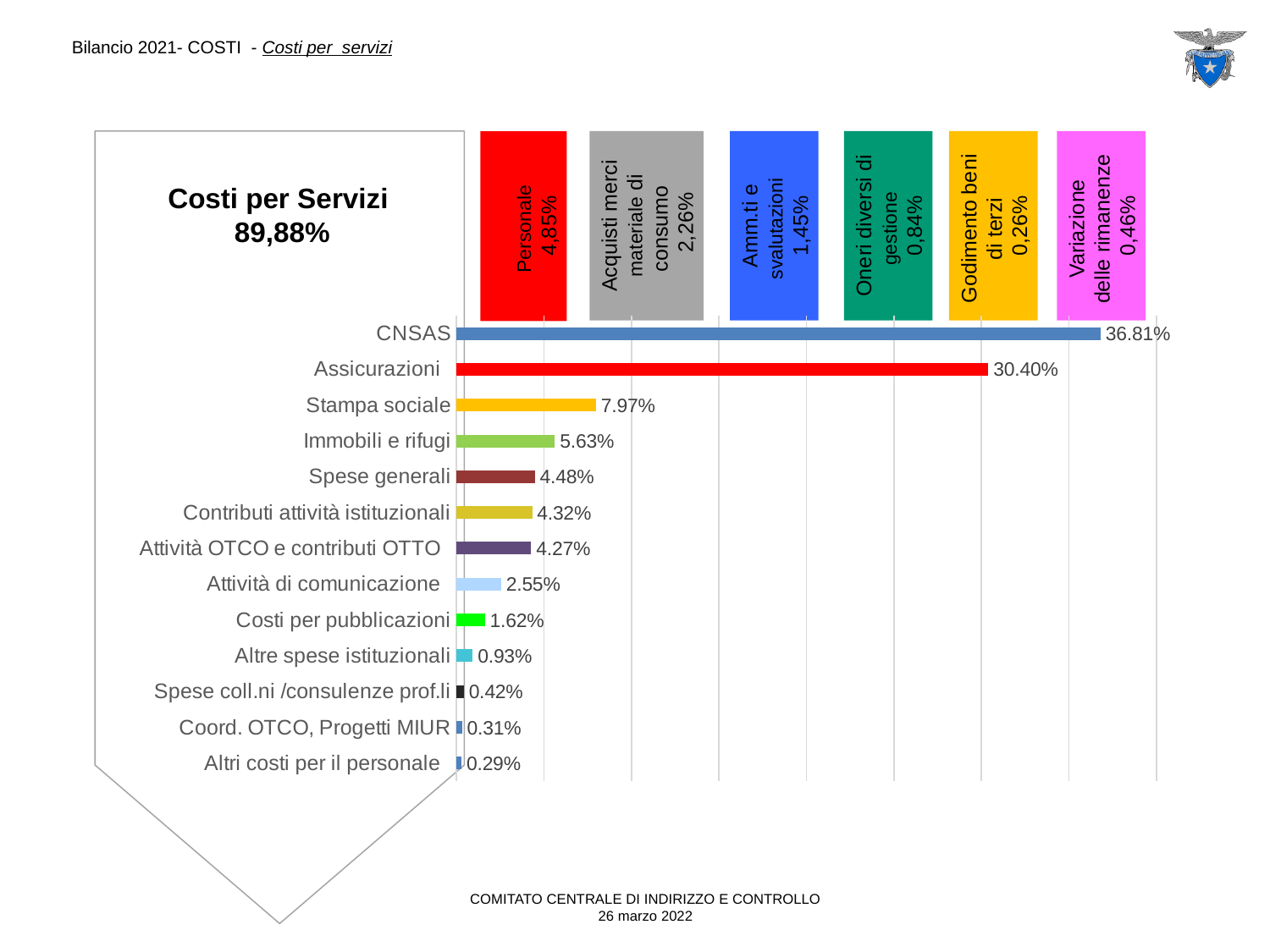
Which is larger, the value for Spese generali or the value for Contributi attività istituzionali? Spese generali What is the value for Attività di comunicazione? 2.55% How many categories are shown in the bar chart? 13 What is the value for Stampa sociale? 7.97% What percentage is shown in the 'Costi per Servizi' label box to the left of the chart? 89,88% Which category has the highest value? CNSAS What kind of chart is shown on the slide? bar chart What is the value for CNSAS? 36.81% What is the value for Assicurazioni? 30.40% What is the difference between the values for Stampa sociale and Immobili e rifugi? 2.34% What is the difference between the values for CNSAS and Assicurazioni? 6.41% Which category has the lowest value? Altri costi per il personale